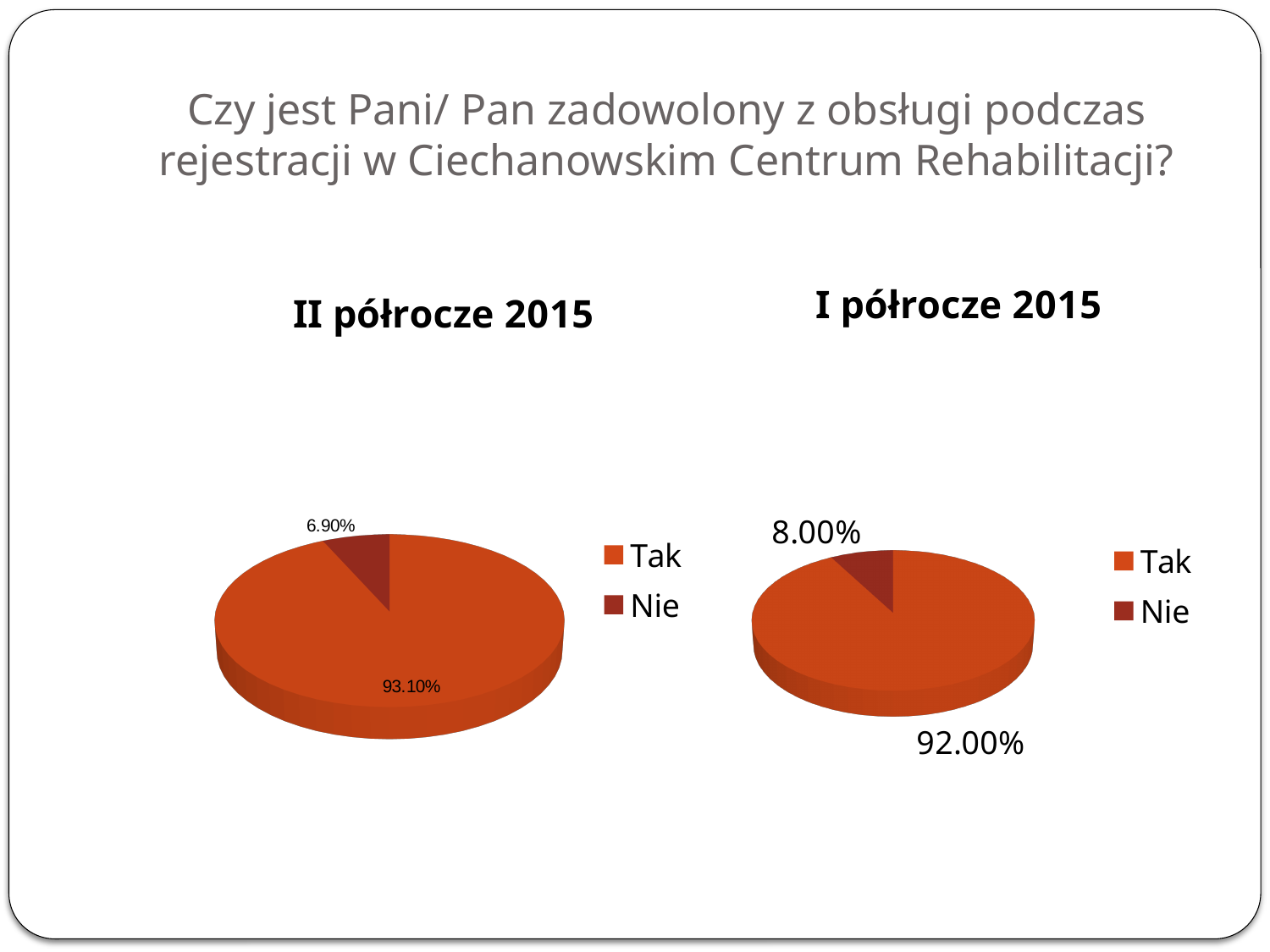
What type of chart is used on this slide? Pie chart How many categories does the legend of the 'I półrocze 2015' chart list? 2 In the 'II półrocze 2015' chart, what percentage is shown for Nie? 6.90% In the 'II półrocze 2015' chart, which category has the largest slice? Tak In the 'II półrocze 2015' chart, what percentage is shown for Tak? 93.10% How many pie charts are shown on the slide? 2 What is the title of the chart on the left? II półrocze 2015 In the 'I półrocze 2015' chart, what percentage is shown for Nie? 8.00% In the 'II półrocze 2015' chart, what is the difference between the Tak and Nie percentages? 86.20% In the 'I półrocze 2015' chart, what percentage is shown for Tak? 92.00% In the 'I półrocze 2015' chart, which category has the smallest slice? Nie Is the Nie share larger in the 'I półrocze 2015' chart or the 'II półrocze 2015' chart? I półrocze 2015